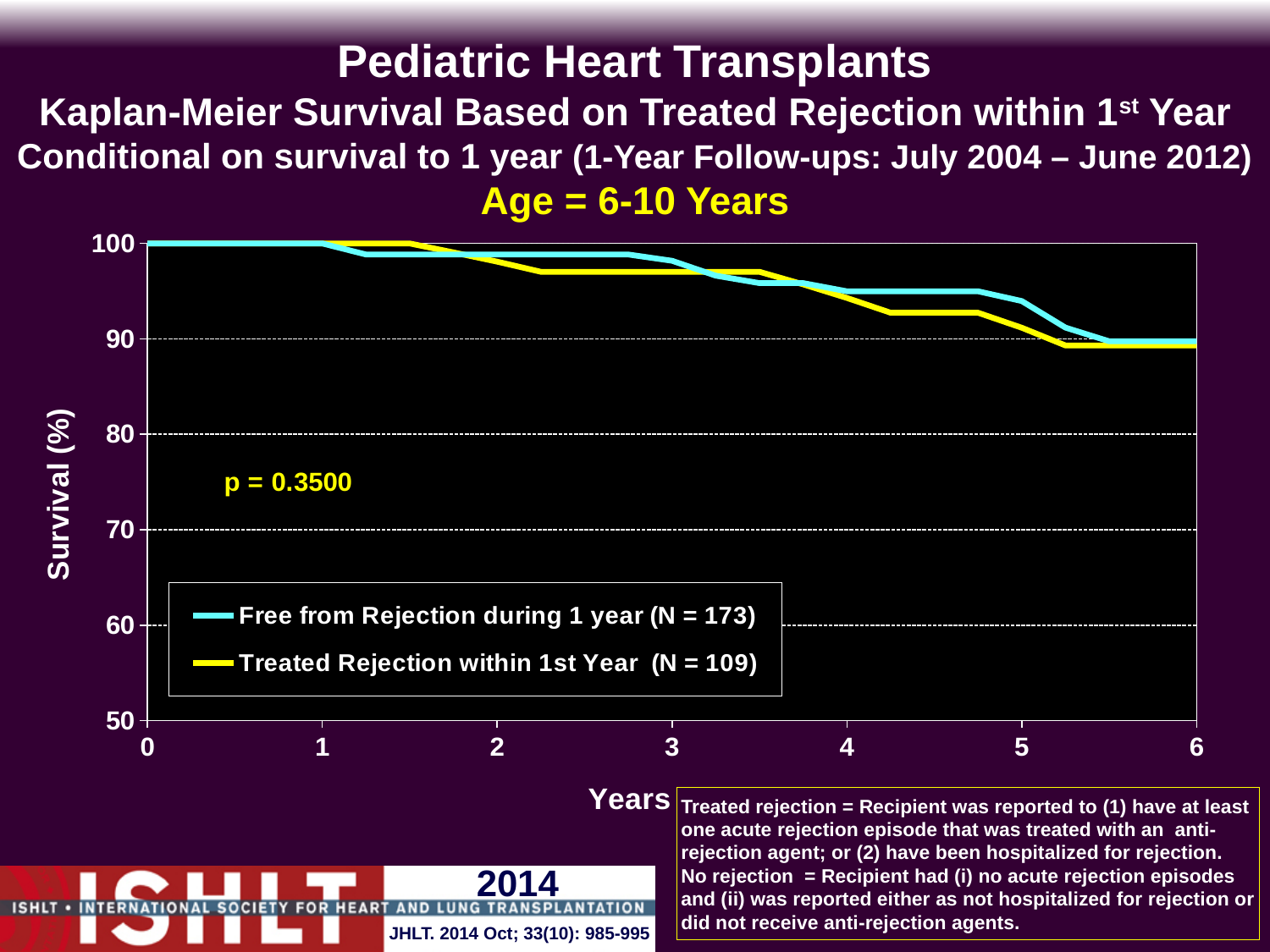
What is the N for the Treated Rejection within 1st Year group in the legend? 109 Is the survival value for the Treated Rejection within 1st Year group at year 4 greater or less than 90? greater What is the survival value for the Free from Rejection during 1 year group at year 0? 100 Is the survival value for the Free from Rejection during 1 year group at year 3 greater or less than 100? less Do the survival curves rise or fall as years increase? Fall At year 5, which group has the higher survival: Free from Rejection during 1 year or Treated Rejection within 1st Year? Free from Rejection during 1 year How many tick marks are labelled on the Years axis? 7 Is the survival value for the Free from Rejection during 1 year group at year 5 greater or less than 90? greater What is the survival value for the Treated Rejection within 1st Year group at year 0? 100 How many series does the legend list? 2 What kind of chart is shown on the slide? Line chart What p-value is printed on the chart? p = 0.3500